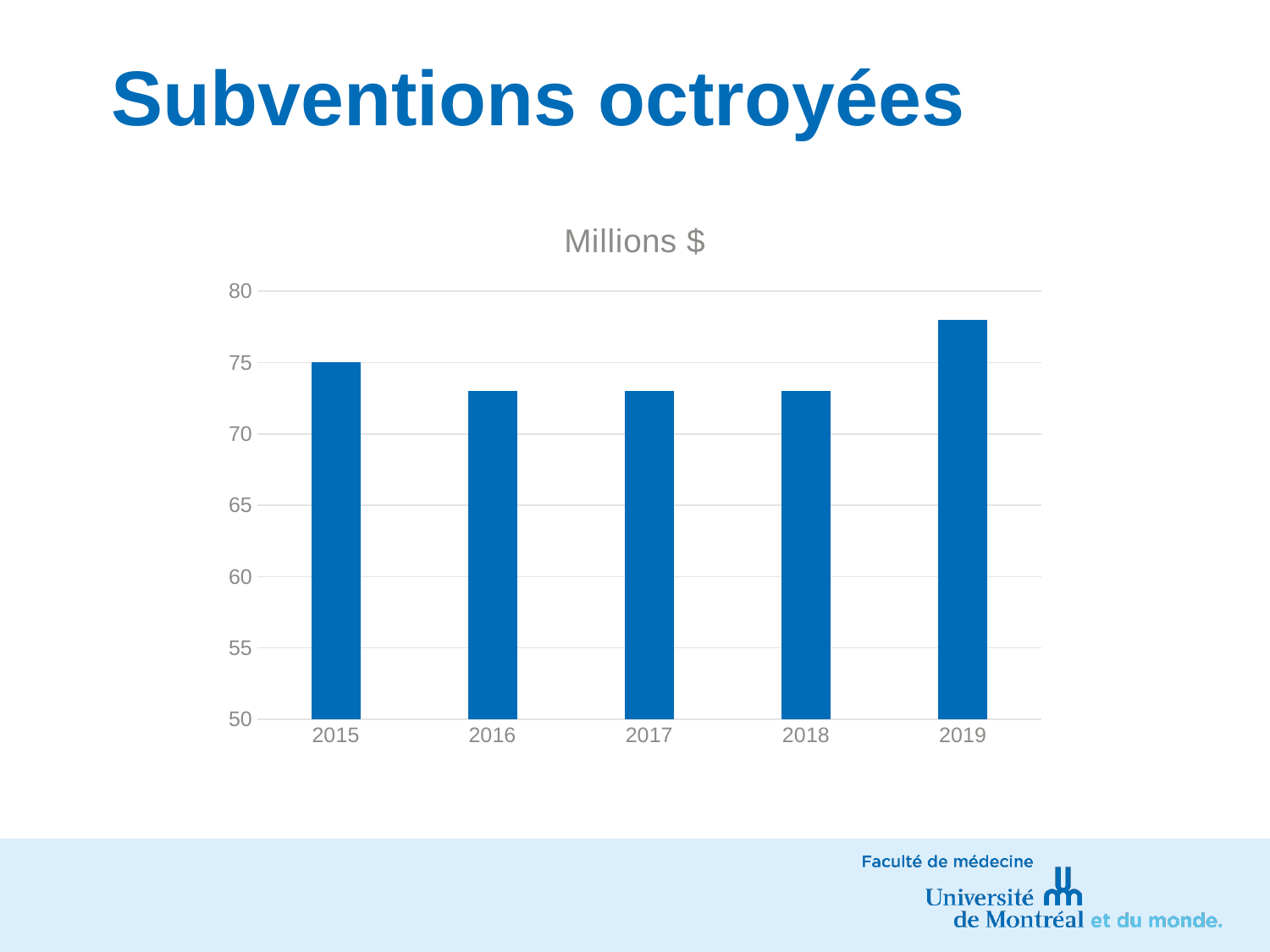
Is the value for 2019 greater or less than 75? greater Is the value for 2016 greater or less than 75? less What is the title of the chart? Millions $ Is the value for 2017 greater or less than 70? greater Which is larger, the value for 2015 or the value for 2019? 2019 Does the value rise or fall from 2018 to 2019? rise Which is larger, the value for 2015 or the value for 2016? 2015 What kind of chart is shown on the slide? bar chart What is the value for 2015? 75 How many years are shown on the x axis of the chart? 5 Which year has the highest value? 2019